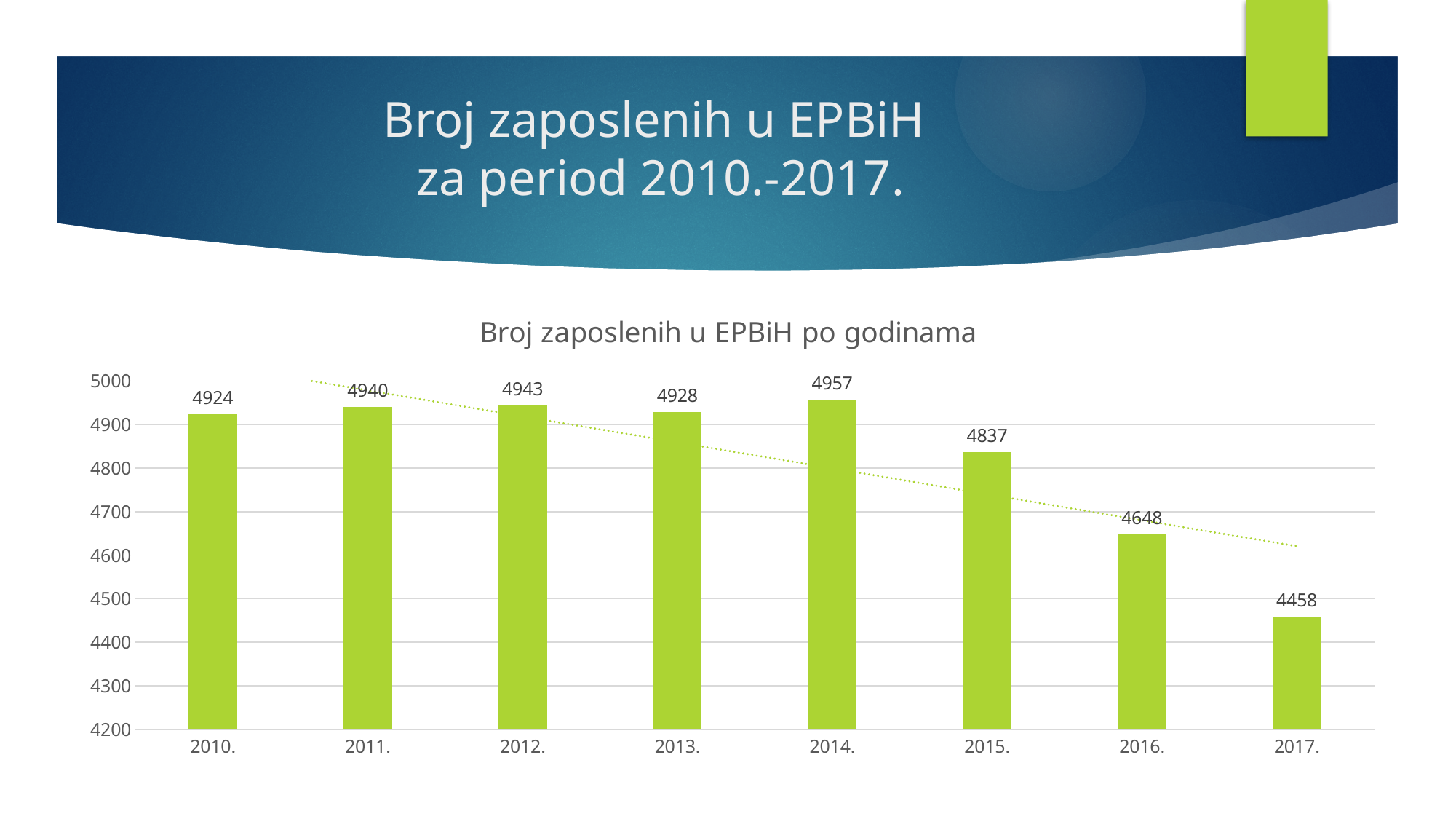
What is the difference between the values for 2014. and 2017.? 499 Is the value for 2016. greater or less than 4700? less Which year has the lowest number of employees? 2017. Which year has the highest number of employees? 2014. What kind of chart is shown on the slide? bar chart What is the title of the chart? Broj zaposlenih u EPBiH po godinama What is the number of employees shown for 2017.? 4458 What is the difference between the values for 2015. and 2016.? 189 What is the value for 2015.? 4837 What is the number of employees shown for 2014.? 4957 Which is larger, the value for 2011. or the value for 2013.? 2011. How many years are shown on the x axis? 8